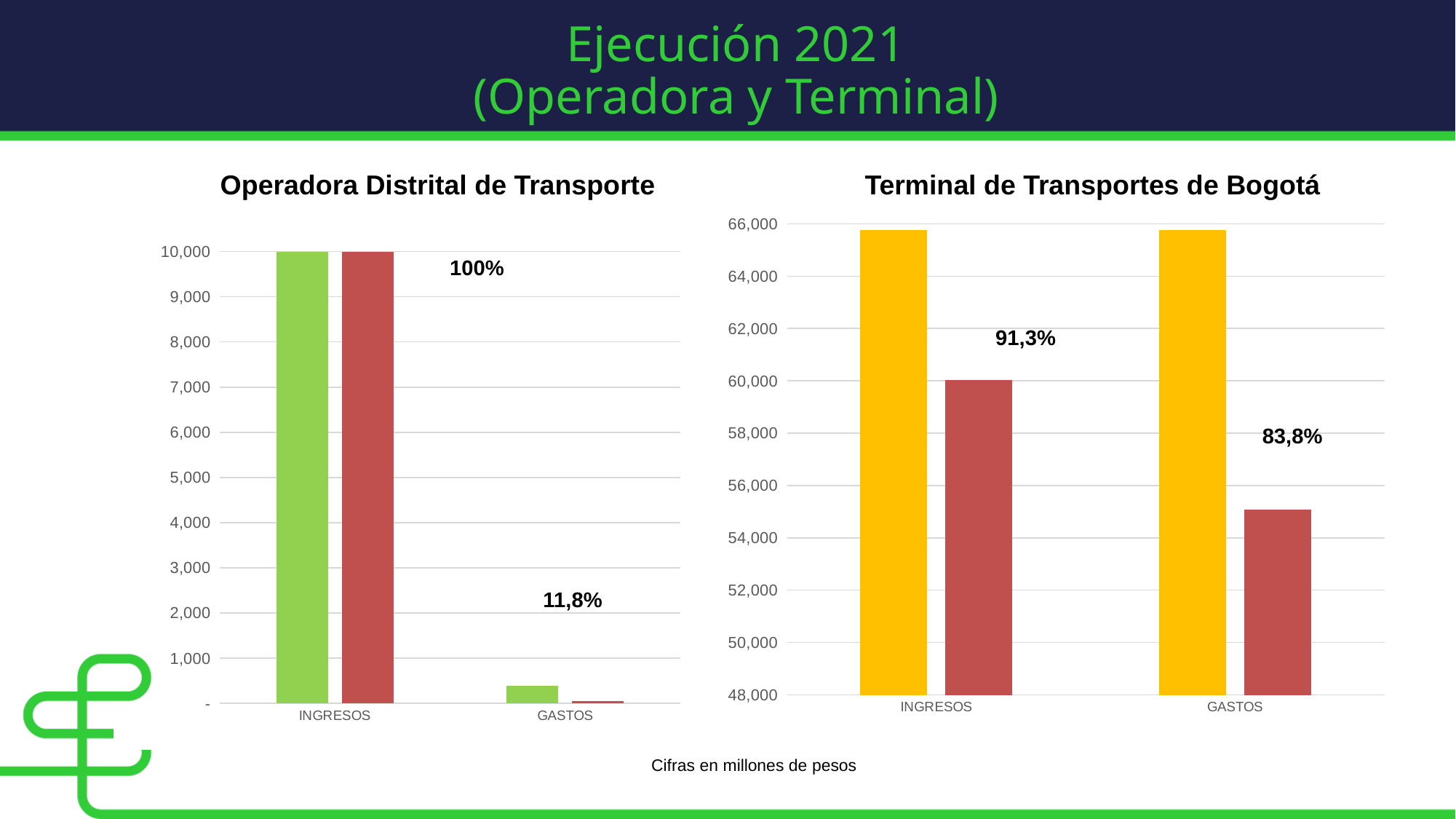
In the 'Operadora Distrital de Transporte' chart, what percentage label is shown next to GASTOS? 11,8% In the 'Operadora Distrital de Transporte' chart, is the green GASTOS bar greater or less than 1,000? less What note about units is printed below the charts? Cifras en millones de pesos In the 'Operadora Distrital de Transporte' chart, which category has the lowest bars? GASTOS In the 'Operadora Distrital de Transporte' chart, what percentage label is shown next to INGRESOS? 100% In the 'Terminal de Transportes de Bogotá' chart, what percentage label is shown next to GASTOS? 83,8% How many categories are shown on the x axis of the 'Terminal de Transportes de Bogotá' chart? 2 What kind of chart is the 'Operadora Distrital de Transporte' chart? bar chart In the 'Operadora Distrital de Transporte' chart, what value do the INGRESOS bars reach? 10,000 In the 'Terminal de Transportes de Bogotá' chart, which red bar is taller, INGRESOS or GASTOS? INGRESOS In the 'Terminal de Transportes de Bogotá' chart, is the yellow INGRESOS bar greater or less than 64,000? greater In the 'Terminal de Transportes de Bogotá' chart, is the red GASTOS bar greater or less than 56,000? less